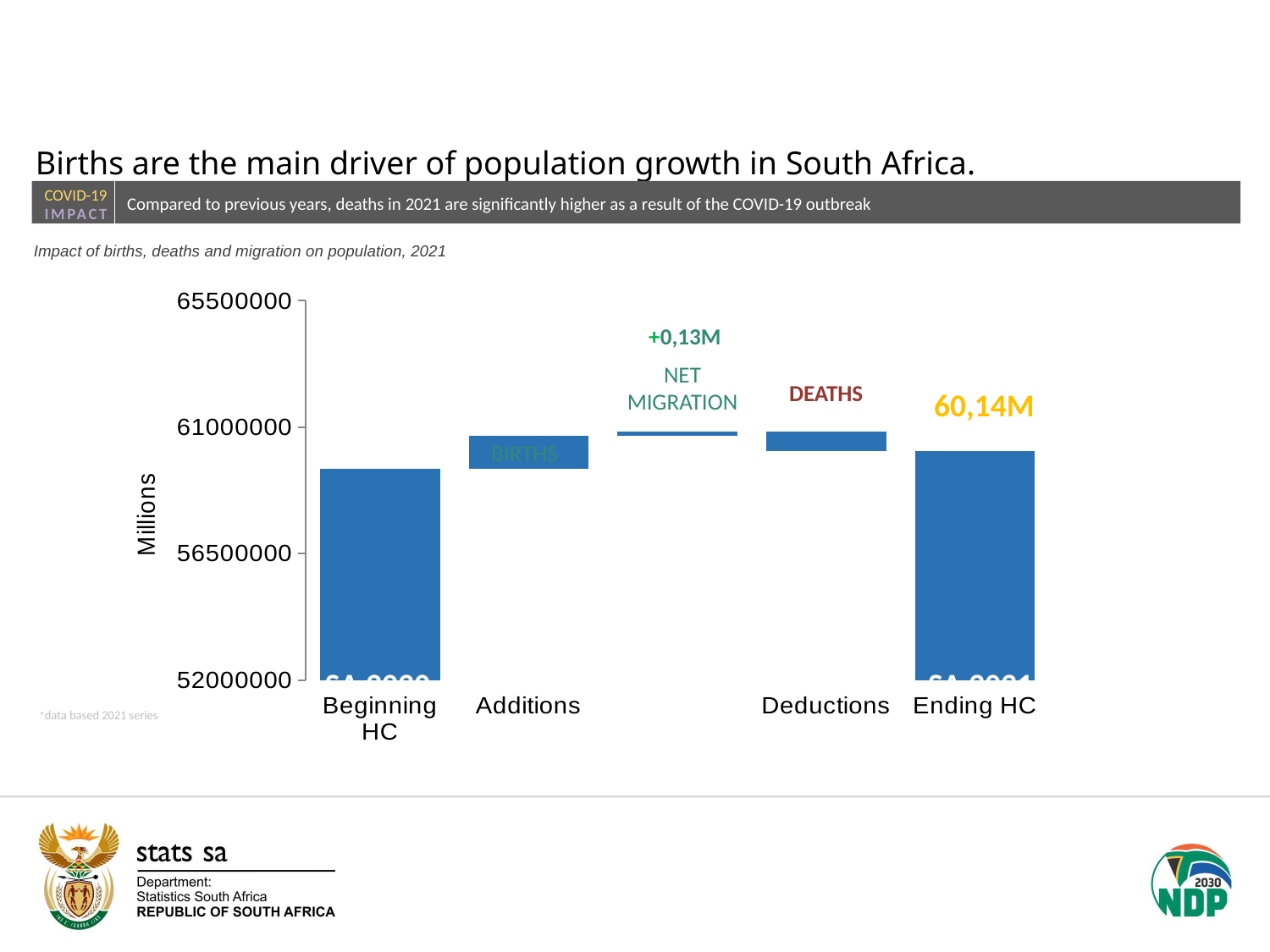
What value is shown for net migration? +0,13M What is the label on the y axis? Millions Is the value for Ending HC greater or less than 61000000? less Does the population rise or fall from Beginning HC to Ending HC? rise Which x-axis category is labelled DEATHS? Deductions Which is larger, the Beginning HC bar or the Ending HC bar? Ending HC Is the value for Beginning HC greater or less than 61000000? less What is the highest tick value shown on the y axis? 65500000 What is the value shown for Ending HC? 60,14M What kind of chart is shown on the slide? bar chart Is the value for Beginning HC greater or less than 56500000? greater How many labelled categories are on the x axis? 4